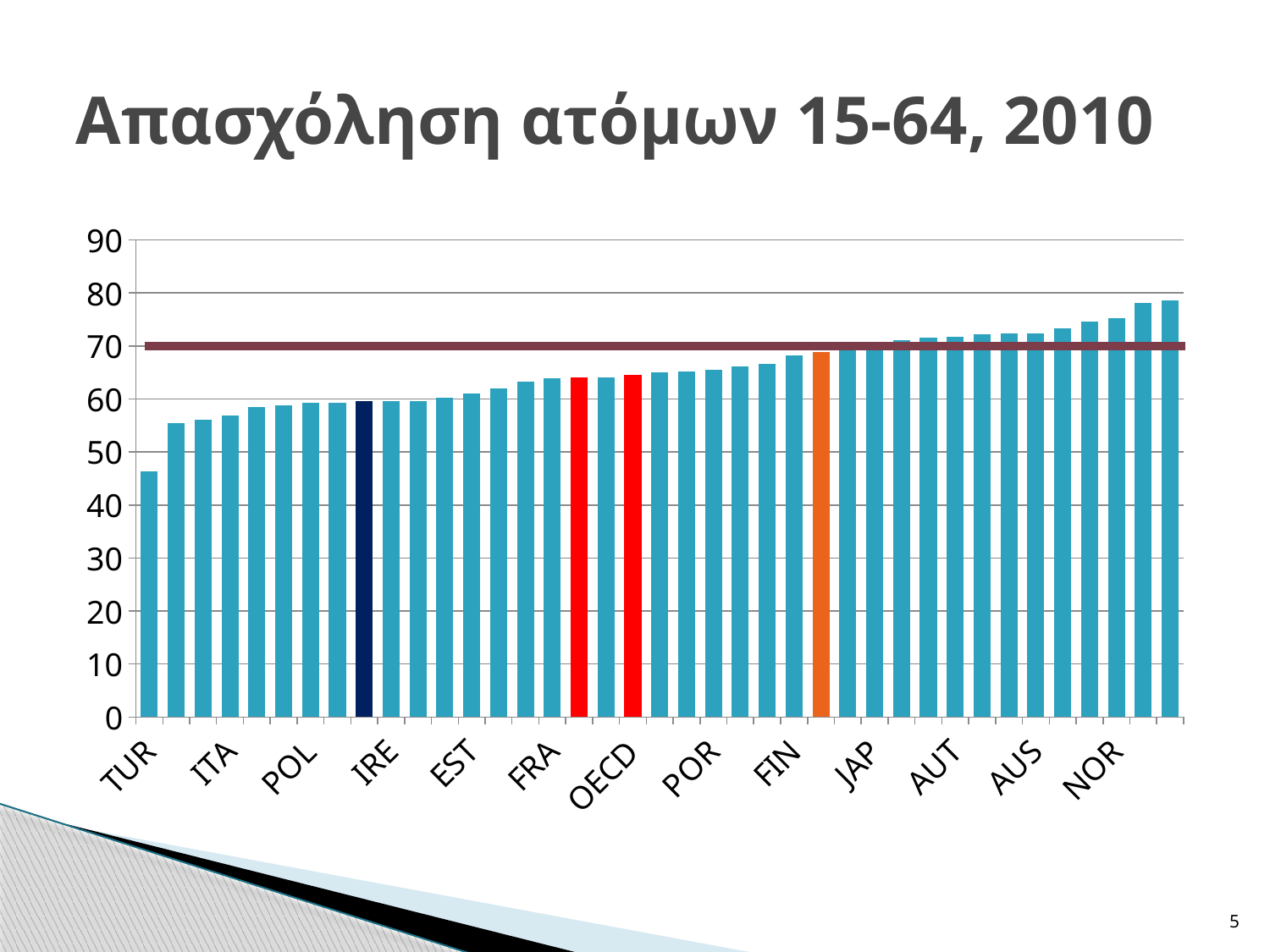
Is the value for POR greater or less than 70? less Which has the larger value, ITA or FIN? FIN What kind of chart is shown on the slide? bar chart Do the bar values rise or fall from left to right along the x axis? rise What is the title of the chart? Απασχόληση ατόμων 15-64, 2010 Which has the larger value, TUR or NOR? NOR Which labelled country has the lowest value in the chart? TUR Is the value for ITA greater or less than 60? less Is the value for FRA greater or less than 60? greater